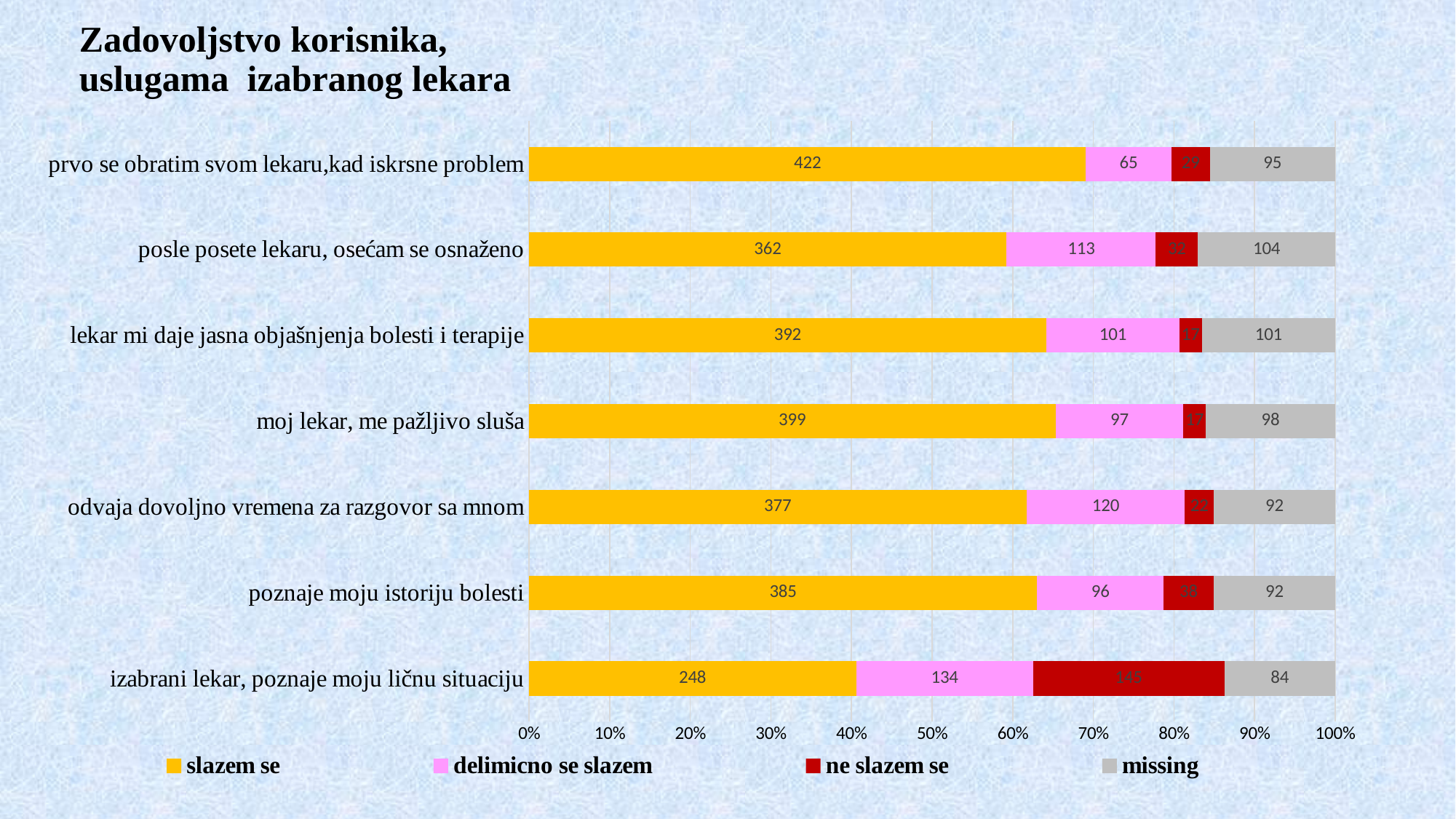
What is the difference between the "slazem se" values for "moj lekar, me pažljivo sluša" and "poznaje moju istoriju bolesti"? 14 Which has a larger "delimicno se slazem" value: "posle posete lekaru, osećam se osnaženo" or "lekar mi daje jasna objašnjenja bolesti i terapije"? posle posete lekaru, osećam se osnaženo What is the value of "slazem se" for "prvo se obratim svom lekaru,kad iskrsne problem"? 422 What is the "missing" value for "posle posete lekaru, osećam se osnaženo"? 104 Which category has the lowest "slazem se" value? izabrani lekar, poznaje moju ličnu situaciju How many categories (statements) are shown in the chart? 7 What is the value of "delimicno se slazem" for "odvaja dovoljno vremena za razgovor sa mnom"? 120 Which category has the highest "slazem se" value? prvo se obratim svom lekaru,kad iskrsne problem What is the total of the stacked bar for "izabrani lekar, poznaje moju ličnu situaciju"? 611 What is the "missing" value for "izabrani lekar, poznaje moju ličnu situaciju"? 84 How many series does the legend list? 4 What kind of chart is shown on the slide? Stacked bar chart